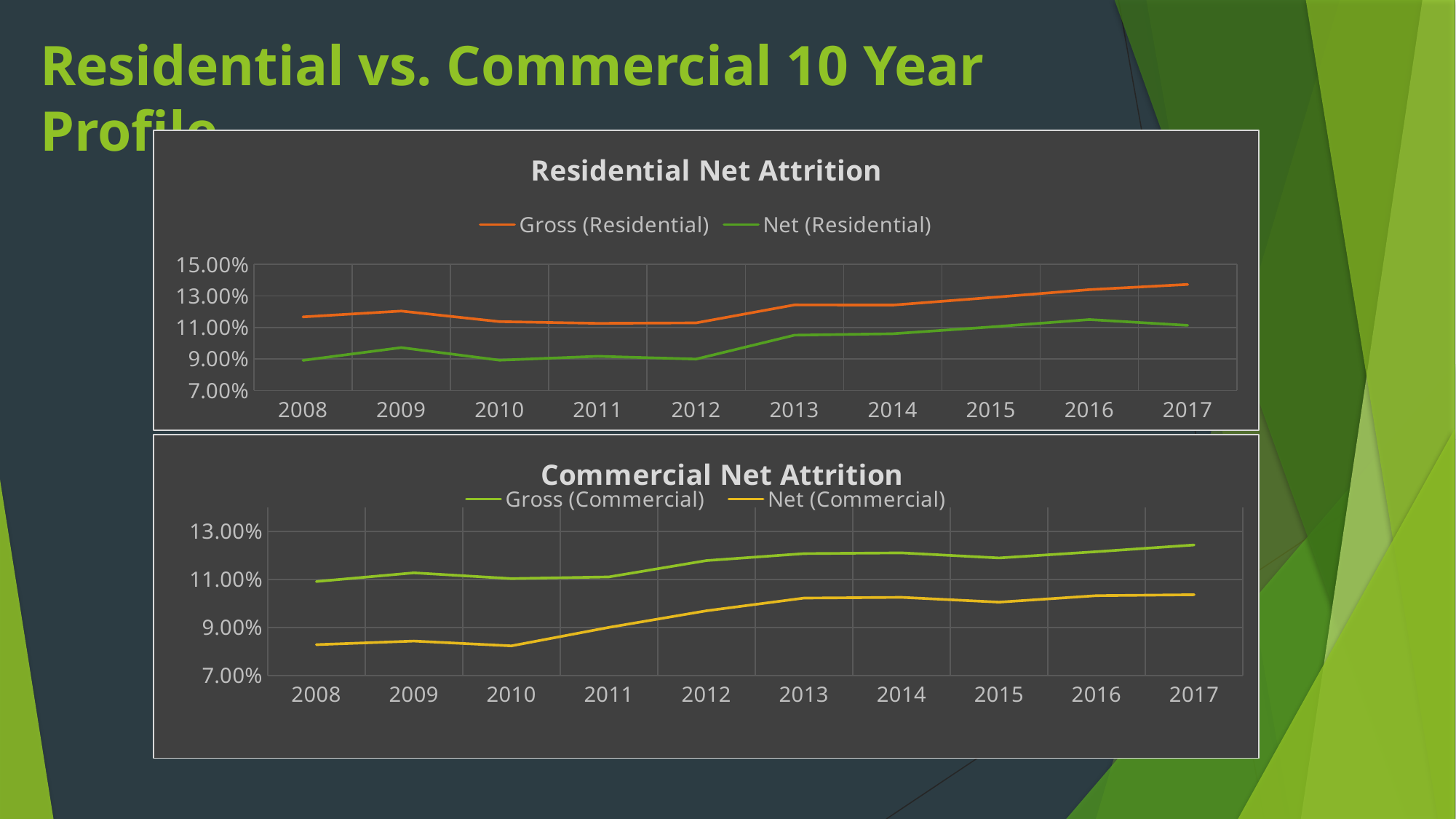
In the Residential Net Attrition chart, is the Gross (Residential) value for 2017 greater or less than 13.00%? greater How many series does the legend of the Commercial Net Attrition chart list? 2 In the Commercial Net Attrition chart, which year has the highest Gross (Commercial) value? 2017 In the Commercial Net Attrition chart, is the Net (Commercial) value for 2008 greater or less than 9.00%? less In the Residential Net Attrition chart, which year has the highest Gross (Residential) value? 2017 In the Commercial Net Attrition chart, does the Net (Commercial) line generally rise or fall from 2010 to 2013? rise What is the title of the top chart on the slide? Residential Net Attrition In the Commercial Net Attrition chart, is the Gross (Commercial) value for 2017 greater or less than 13.00%? less How many years are shown on the x axis of the Residential Net Attrition chart? 10 In the Commercial Net Attrition chart, which is larger in 2012: Gross (Commercial) or Net (Commercial)? Gross (Commercial) What kind of chart is the Residential Net Attrition chart? line chart